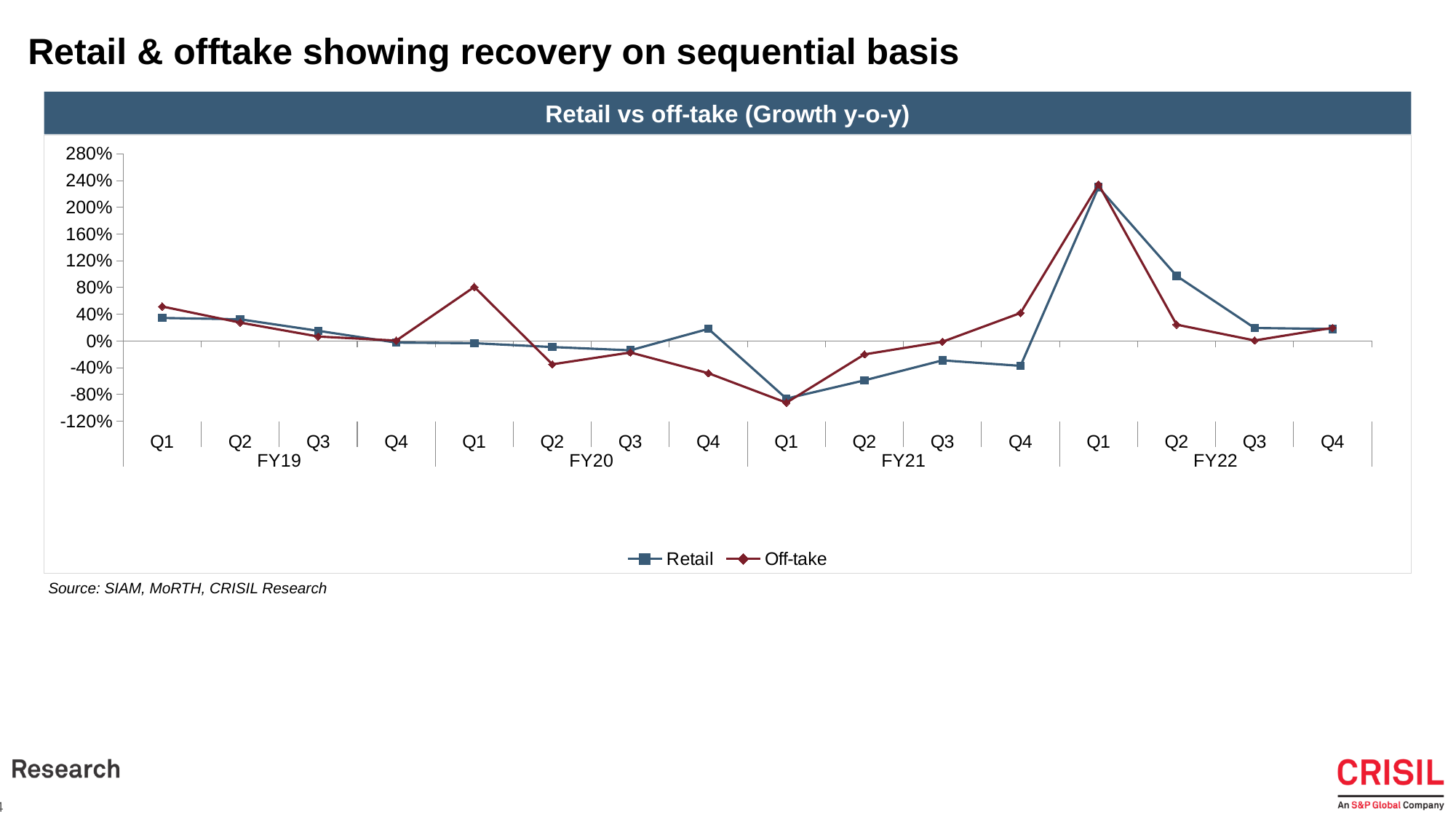
What kind of chart is shown on the slide? Line chart What is the title of the chart? Retail vs off-take (Growth y-o-y) Does the Retail series rise or fall from Q1 FY22 to Q4 FY22? Fall Is the Retail value for Q1 FY21 greater or less than -40%? less How many series does the legend list? 2 In Q1 FY20, which series has the higher value, Retail or Off-take? Off-take In which quarter does the Off-take series reach its lowest value? Q1 FY21 In which quarter does the Retail series reach its highest value? Q1 FY22 How many quarterly data points are plotted along the x axis? 16 Is the Retail value for Q1 FY22 greater or less than 200%? greater Is the Off-take value for Q2 FY20 greater or less than 0%? less In Q4 FY20, which series has the higher value, Retail or Off-take? Retail